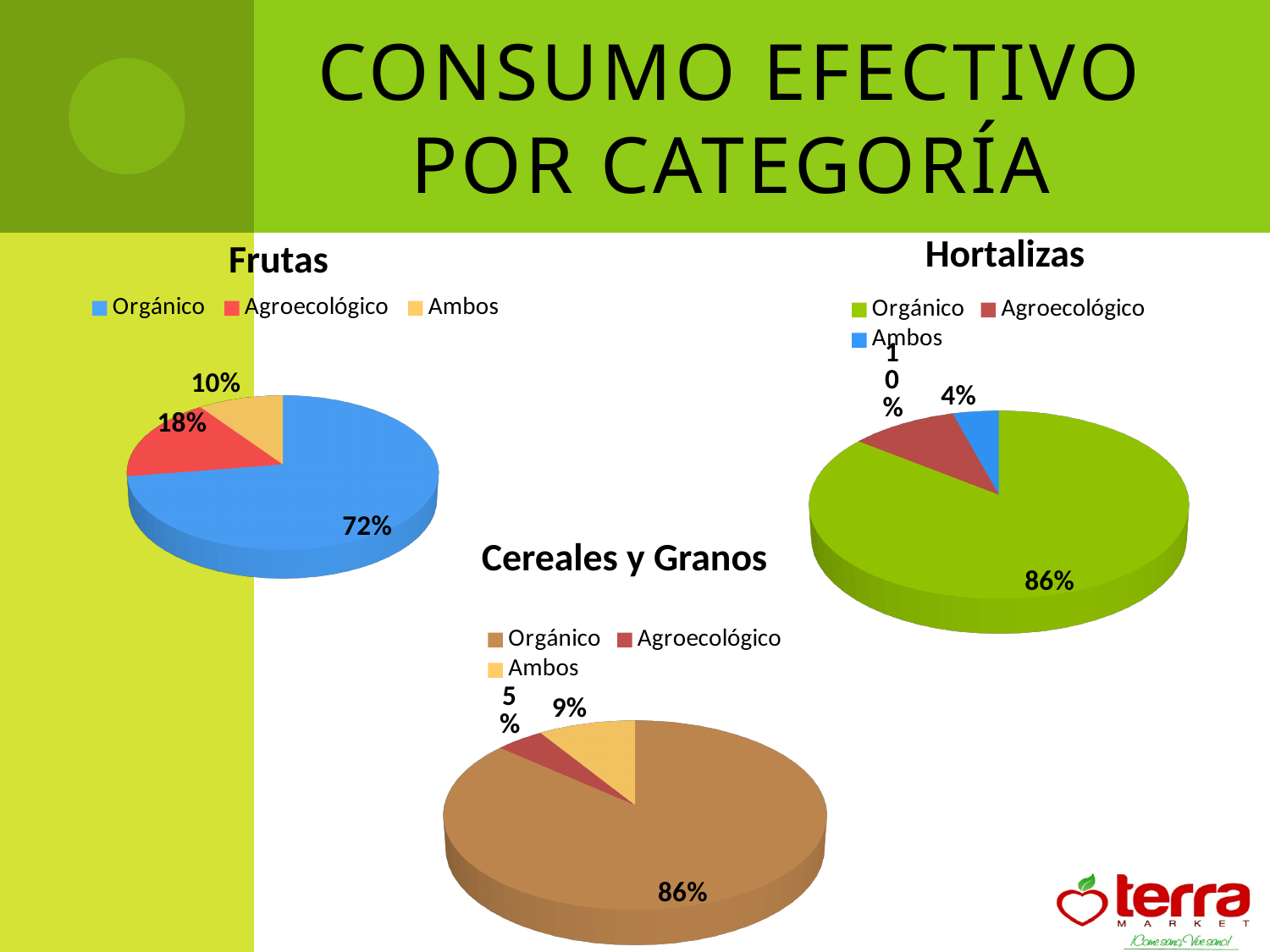
In the Frutas chart, what share does Ambos have? 10% In the Hortalizas chart, which category has the smallest slice? Ambos In the Hortalizas chart, what share does Orgánico have? 86% In the Frutas chart, what is the difference between the Orgánico and Agroecológico shares? 54% In the Cereales y Granos chart, which category has the largest slice? Orgánico In the Cereales y Granos chart, which is larger, Ambos or Agroecológico? Ambos What kind of chart is the Hortalizas chart? Pie chart In the Frutas chart, what share does Agroecológico have? 18% In the Hortalizas chart, what share does Ambos have? 4% How many categories does the legend of the Frutas chart list? 3 In the Frutas chart, what share does Orgánico have? 72% In the Cereales y Granos chart, what share does Agroecológico have? 5%